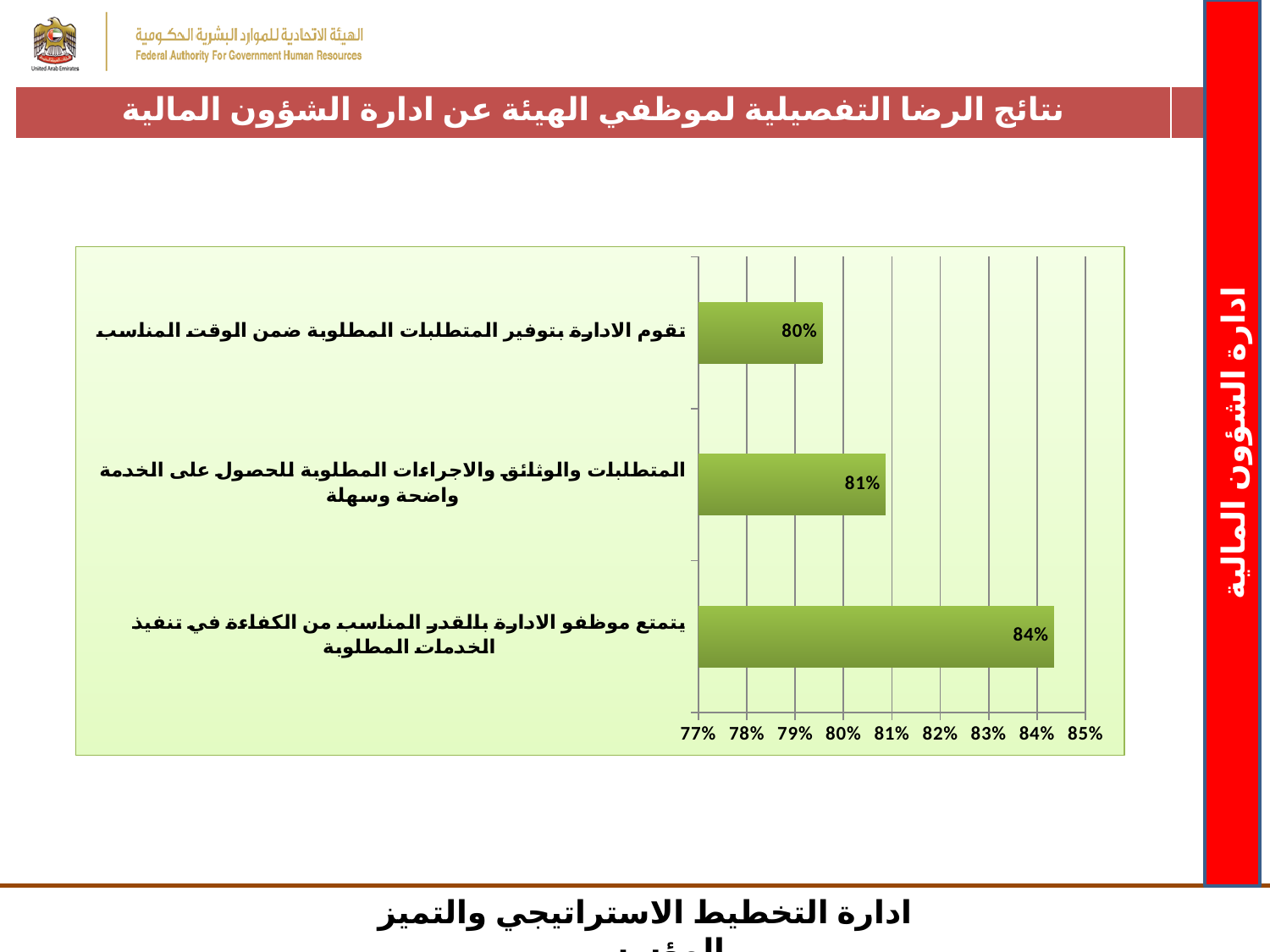
What is the lowest value shown on the horizontal axis of the chart? 77% Which is larger: the value for "المتطلبات والوثائق والاجراءات المطلوبة للحصول على الخدمة واضحة وسهلة" or the value for "تقوم الادارة بتوفير المتطلبات المطلوبة ضمن الوقت المناسب"? المتطلبات والوثائق والاجراءات المطلوبة للحصول على الخدمة واضحة وسهلة What is the value for "يتمتع موظفو الادارة بالقدر المناسب من الكفاءة في تنفيذ الخدمات المطلوبة"? 84% Is the value for "يتمتع موظفو الادارة بالقدر المناسب من الكفاءة في تنفيذ الخدمات المطلوبة" greater or less than 82%? greater Which category has the highest value? يتمتع موظفو الادارة بالقدر المناسب من الكفاءة في تنفيذ الخدمات المطلوبة How many categories (bars) does the chart show? 3 What is the value for "المتطلبات والوثائق والاجراءات المطلوبة للحصول على الخدمة واضحة وسهلة"? 81% What kind of chart is shown on the slide? bar chart Which category has the lowest value? تقوم الادارة بتوفير المتطلبات المطلوبة ضمن الوقت المناسب What is the title of the slide containing the chart? نتائج الرضا التفصيلية لموظفي الهيئة عن ادارة الشؤون المالية What is the value for "تقوم الادارة بتوفير المتطلبات المطلوبة ضمن الوقت المناسب"? 80% What is the difference between the highest value (84%) and the lowest value (80%)? 4%